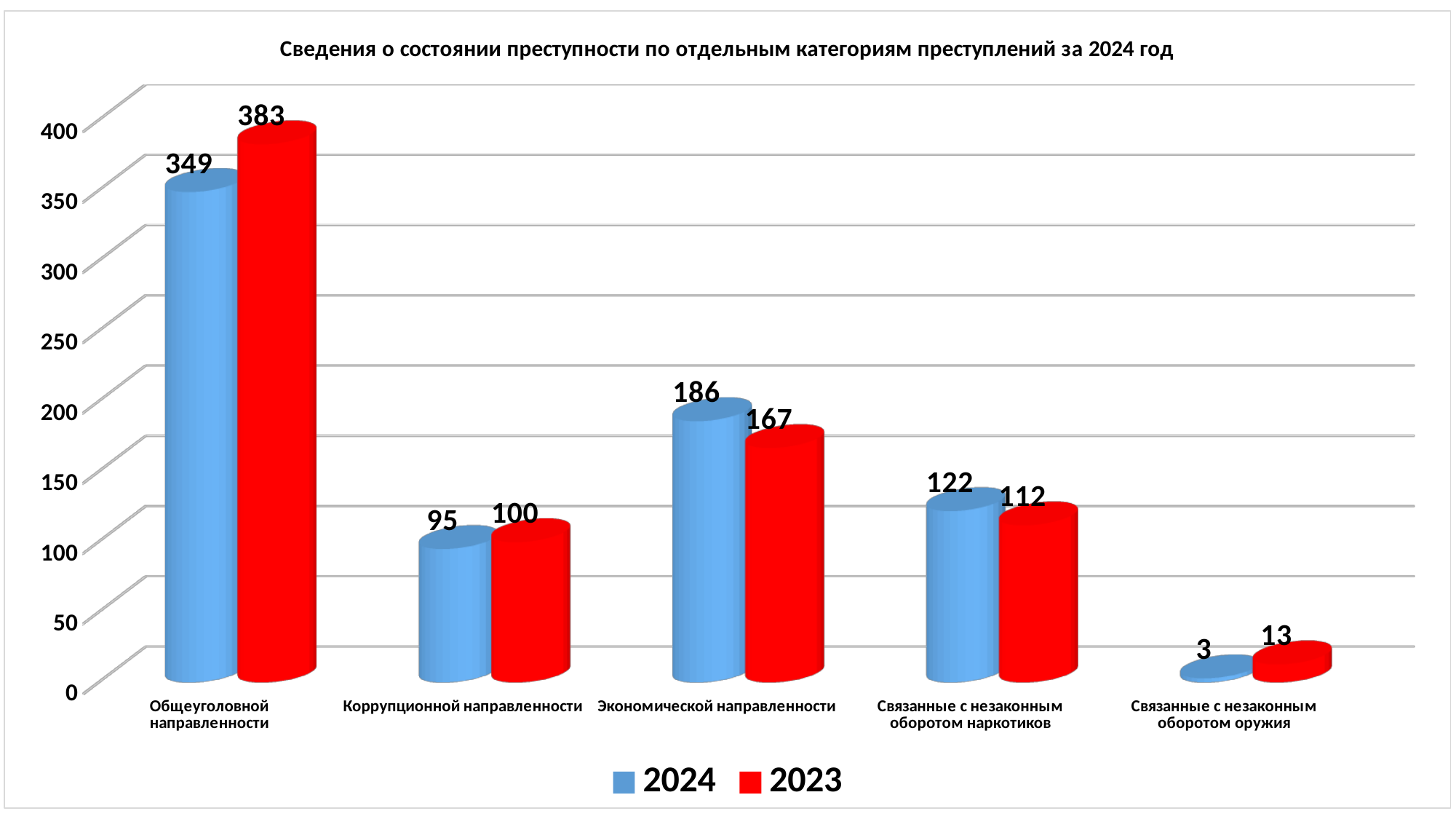
How many categories are shown on the x axis? 5 What is the value for 2023 in the category Экономической направленности? 167 What is the difference between the 2023 and 2024 values for Общеуголовной направленности? 34 Which colour represents the 2023 series in the legend? Red What kind of chart is shown on the slide? Bar chart What is the difference between the 2024 and 2023 values for Связанные с незаконным оборотом наркотиков? 10 What is the value for 2024 in the category Общеуголовной направленности? 349 Which is larger for Коррупционной направленности: the 2024 value or the 2023 value? 2023 Which category has the highest value for 2023? Общеуголовной направленности How many series does the legend list? 2 Which category has the lowest value for 2024? Связанные с незаконным оборотом оружия What is the value for 2023 in the category Связанные с незаконным оборотом оружия? 13